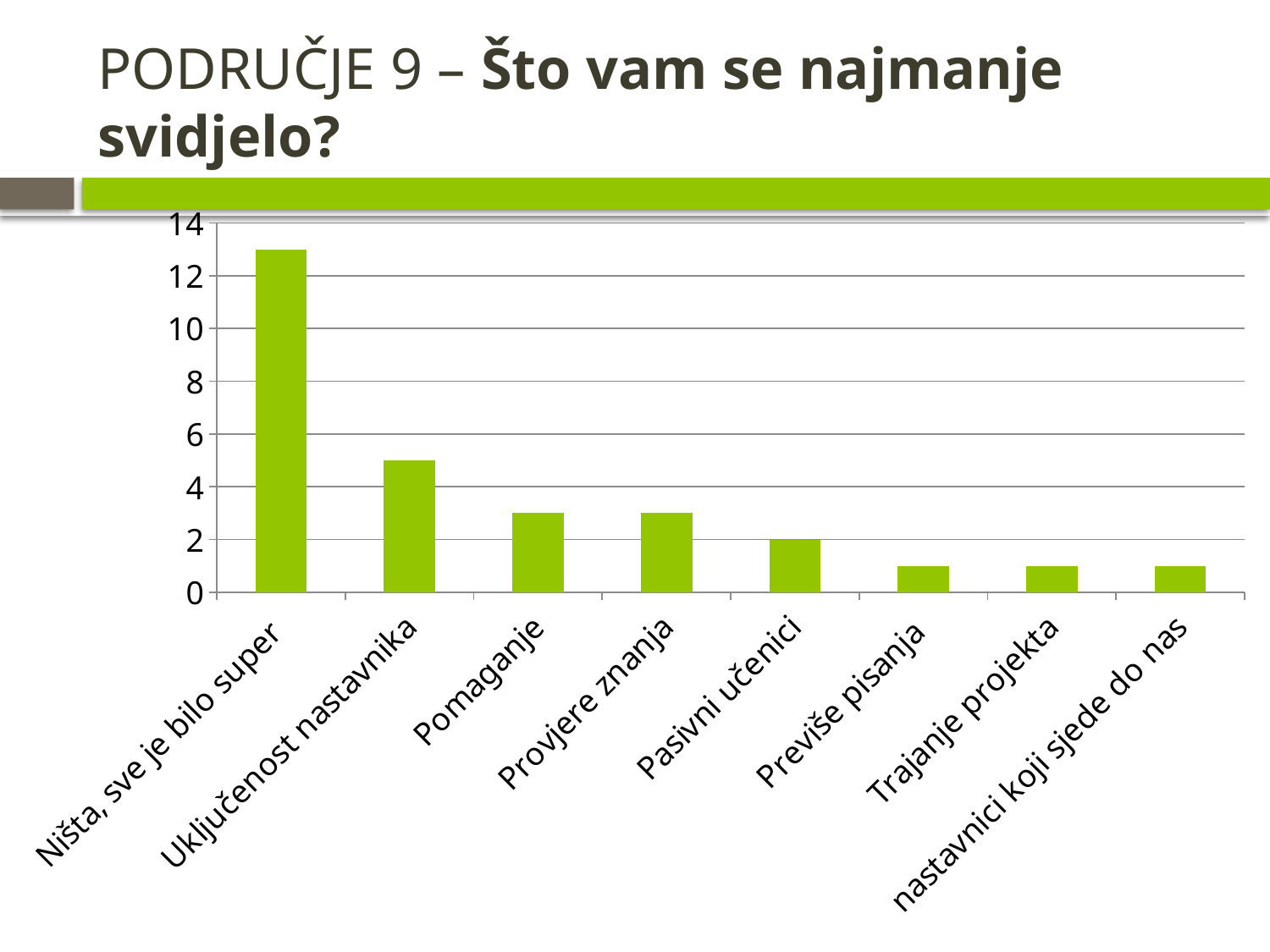
Which is larger, the value for Uključenost nastavnika or the value for Pomaganje? Uključenost nastavnika Is the value for Pomaganje greater or less than 4? less What colour are the bars in the chart? green Is the value for Previše pisanja greater or less than 2? less How many categories are shown on the x axis of the chart? 8 Is the value for Uključenost nastavnika greater or less than 4? greater What kind of chart is shown on the slide? bar chart Do the values generally rise or fall from left to right along the x axis? fall Which category has the highest value in the chart? Ništa, sve je bilo super Which is larger, the value for Provjere znanja or the value for Pasivni učenici? Provjere znanja What is the value for Pasivni učenici? 2